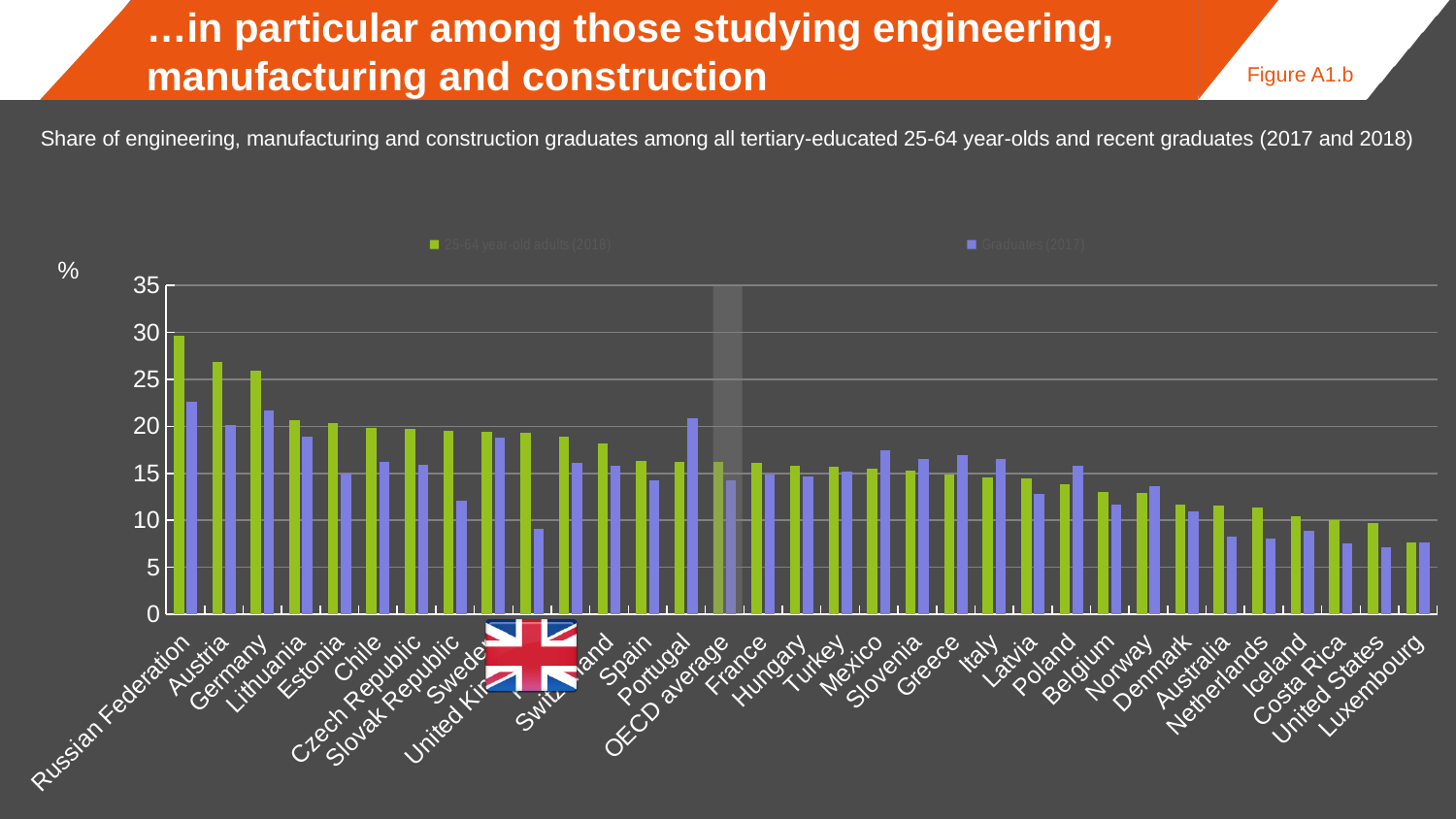
Is the value for Graduates (2017) in Sweden greater or less than 10? greater For the Russian Federation, which is larger: the value for 25-64 year-old adults (2018) or for Graduates (2017)? 25-64 year-old adults (2018) What kind of chart is shown on the slide? bar chart Which country has the lowest share among 25-64 year-old adults (2018)? Luxembourg Is the value for Graduates (2017) in Portugal greater or less than 20? greater For Portugal, which is larger: the value for 25-64 year-old adults (2018) or for Graduates (2017)? Graduates (2017) How many series does the chart's legend list? 2 Is the value for 25-64 year-old adults (2018) in Luxembourg greater or less than 10? less Do the values for 25-64 year-old adults (2018) generally rise or fall from left to right across the countries? fall Which country has the highest share of engineering, manufacturing and construction graduates among 25-64 year-old adults (2018)? Russian Federation